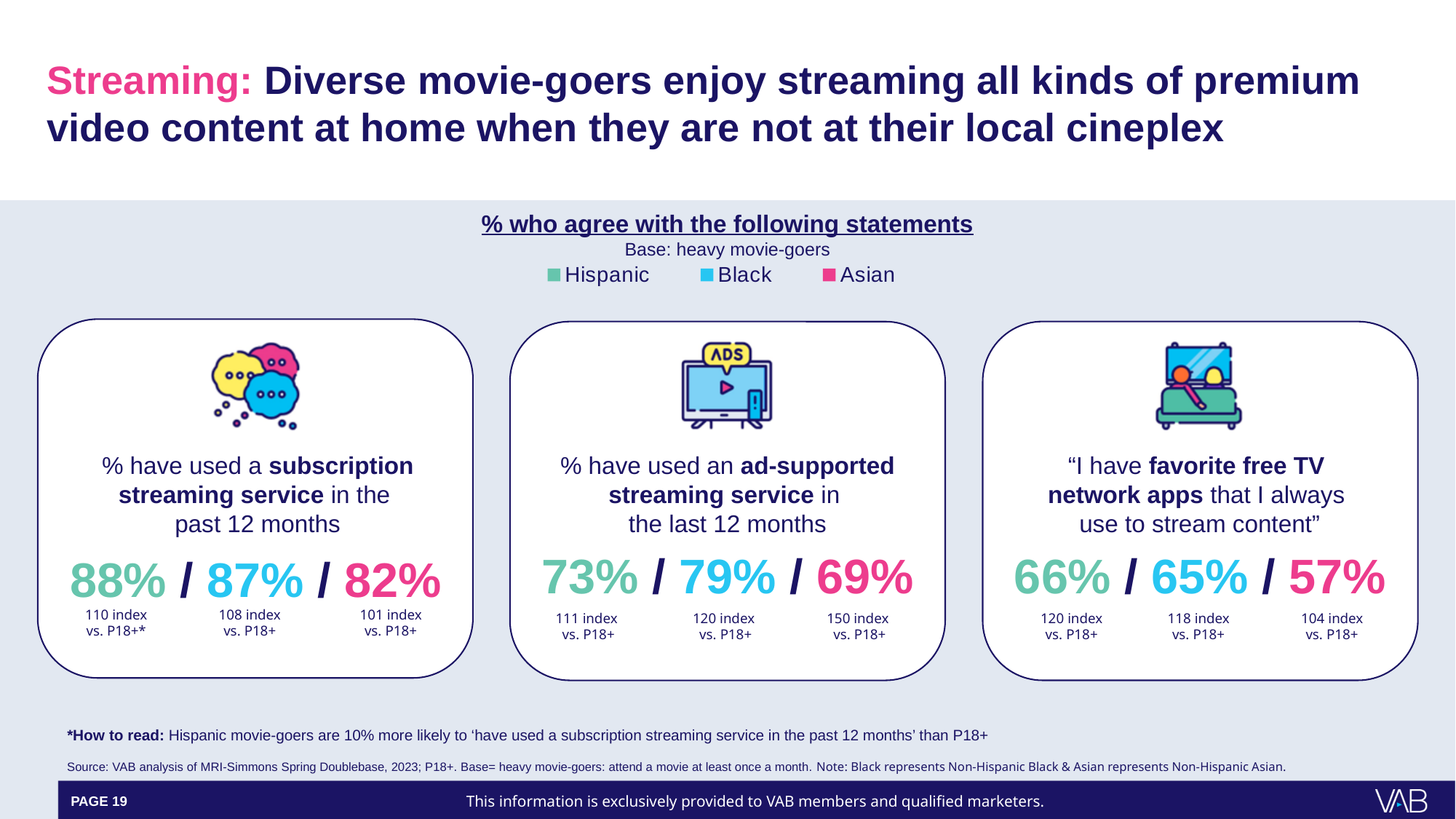
What is the difference between the Black and Asian percentages for having used an ad-supported streaming service? 10 percentage points How many groups does the legend list? 3 Which group has the lowest percentage for having favorite free TV network apps they always use to stream content? Asian What percentage of Black heavy movie-goers have used an ad-supported streaming service in the last 12 months? 79% For the subscription streaming service statement, is the Hispanic value or the Black value larger? Hispanic What percentage of Hispanic heavy movie-goers have used a subscription streaming service in the past 12 months? 88% What is the index vs. P18+ for Asian movie-goers who have used an ad-supported streaming service? 150 index Which group has the highest percentage for having used an ad-supported streaming service in the last 12 months? Black What is the base for the percentages shown on the slide? Heavy movie-goers What percentage of Asian heavy movie-goers agree they have favorite free TV network apps that they always use to stream content? 57% What is the difference between the Hispanic and Asian percentages for having used a subscription streaming service in the past 12 months? 6 percentage points How many statements are shown on the slide? 3